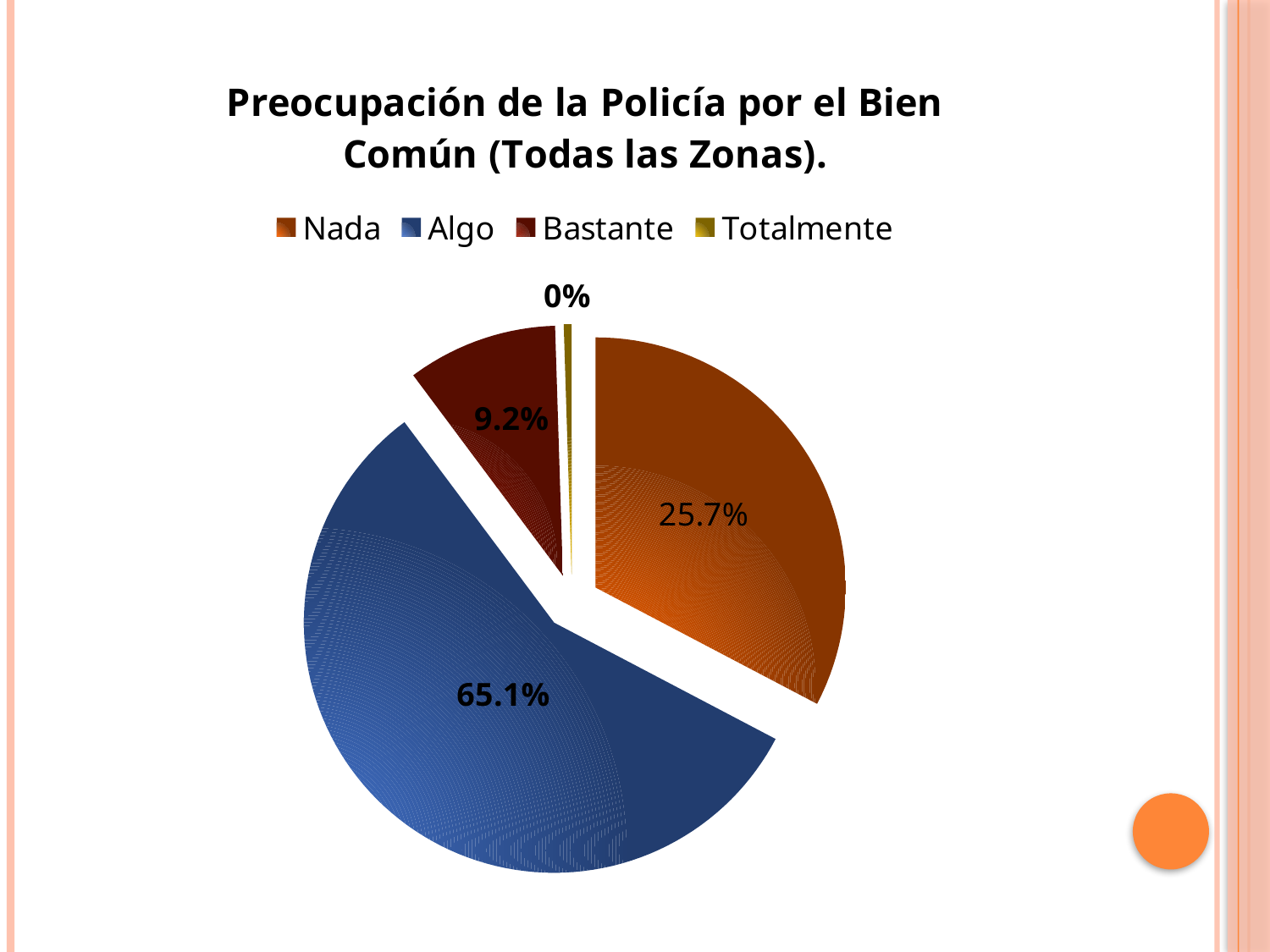
What kind of chart is shown on the slide? Pie chart What is the value shown for the Bastante slice? 9.2% How many categories does the legend list? 4 What is the value shown for the Nada slice? 25.7% Which category has the smallest slice of the pie? Totalmente What is the difference in percentage points between the Algo and Nada slices? 39.4 Which colour represents the Algo category in the legend? Blue What percentage of the pie does the Algo slice represent? 65.1% Which category has the largest slice of the pie? Algo Which is larger, the Nada slice or the Bastante slice? Nada What is the title of the chart? Preocupación de la Policía por el Bien Común (Todas las Zonas). What is the value shown for the Totalmente slice? 0%